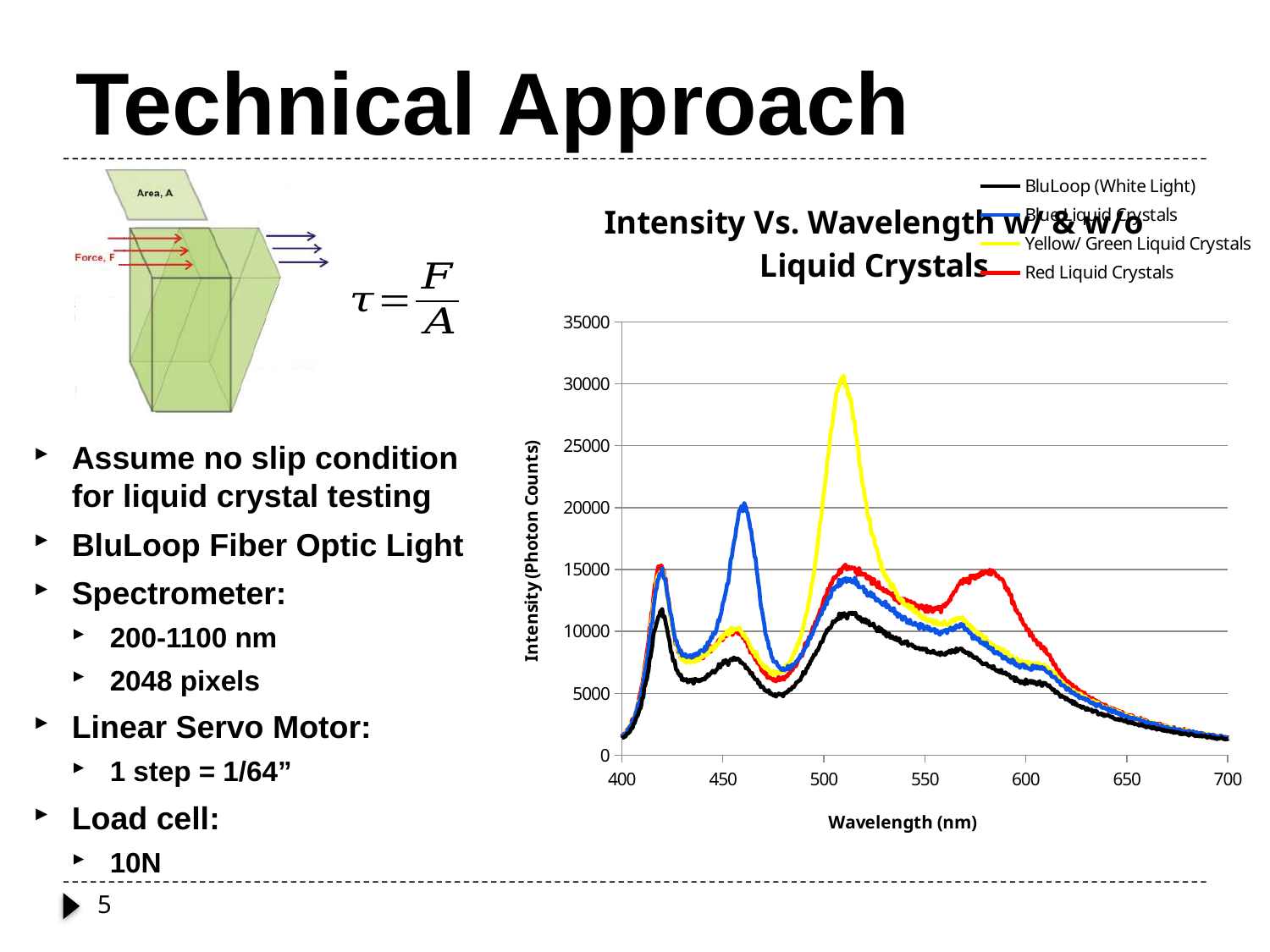
How many series does the chart legend list? 4 What is the title of the chart? Intensity Vs. Wavelength w/ & w/o Liquid Crystals What is the label of the chart's x axis? Wavelength (nm) Which series has the lowest intensity around 500 nm? BluLoop (White Light) Do the intensity values rise or fall as wavelength increases from 600 nm to 700 nm? fall Around 580 nm, which series has the larger intensity: Red Liquid Crystals or BluLoop (White Light)? Red Liquid Crystals What kind of chart is shown on the slide? line chart At 460 nm, which series has the larger intensity: Blue Liquid Crystals or BluLoop (White Light)? Blue Liquid Crystals Which series reaches the highest peak intensity on the chart? Yellow/ Green Liquid Crystals Is the peak value of the Blue Liquid Crystals series near 460 nm greater or less than 15000? greater Is the peak value of the Yellow/ Green Liquid Crystals series greater or less than 25000? greater Is the value of the BluLoop (White Light) series at 500 nm greater or less than 15000? less